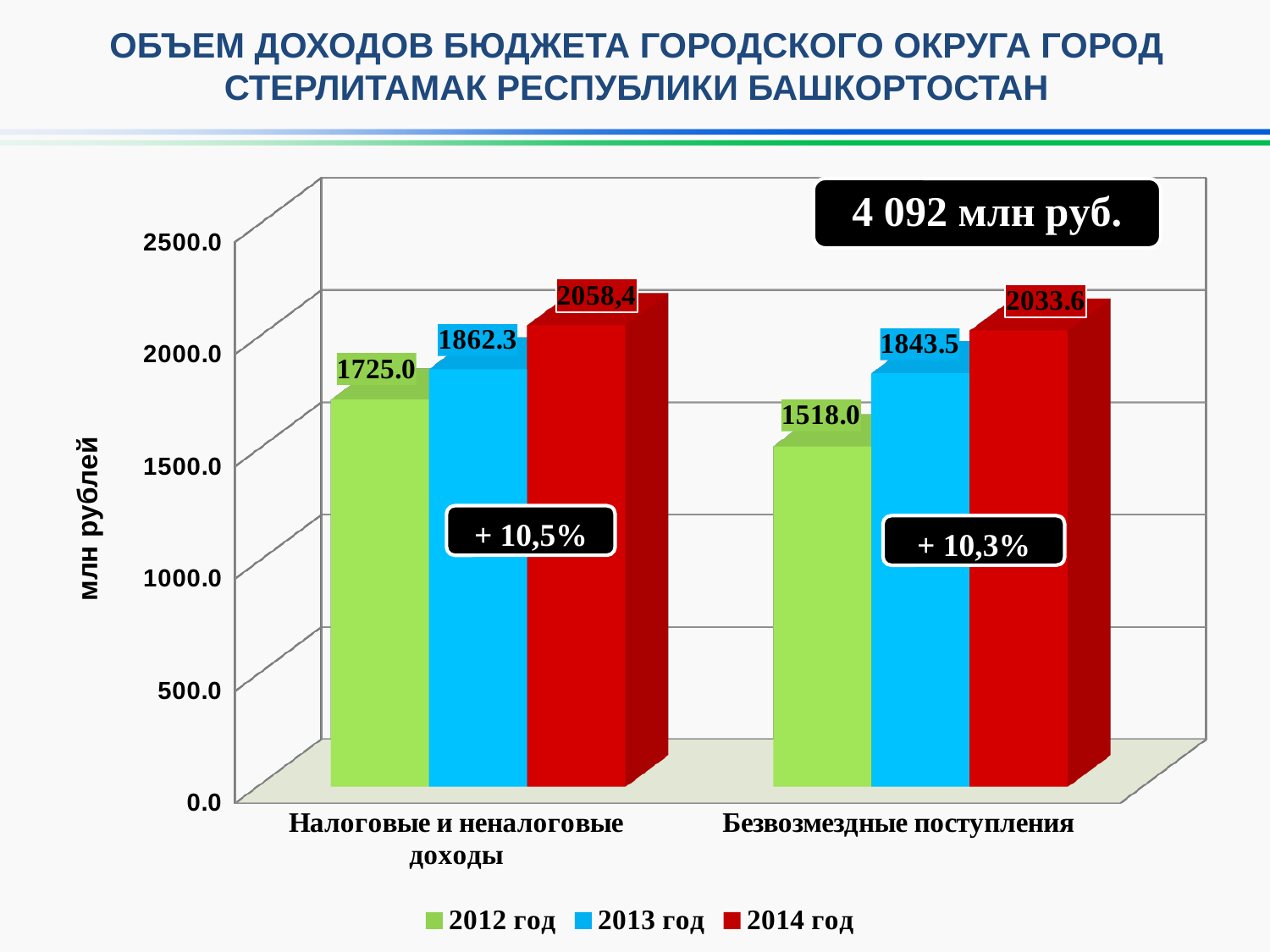
Which year has the lowest value in the category Безвозмездные поступления? 2012 год What kind of chart is shown on the slide? bar chart What is the label of the y axis? млн рублей What is the difference between the 2013 год and 2012 год values for Налоговые и неналоговые доходы? 137.3 Is the 2014 год value for Безвозмездные поступления greater or less than 2000.0? greater What is the value for 2013 год in the category Безвозмездные поступления? 1843.5 How many categories are shown on the x axis? 2 What is the value for 2014 год in the category Безвозмездные поступления? 2033.6 Which year has the highest value in the category Налоговые и неналоговые доходы? 2014 год How many series does the legend list? 3 Which is larger: the 2012 год value for Налоговые и неналоговые доходы or the 2012 год value for Безвозмездные поступления? Налоговые и неналоговые доходы What is the value for 2012 год in the category Налоговые и неналоговые доходы? 1725.0